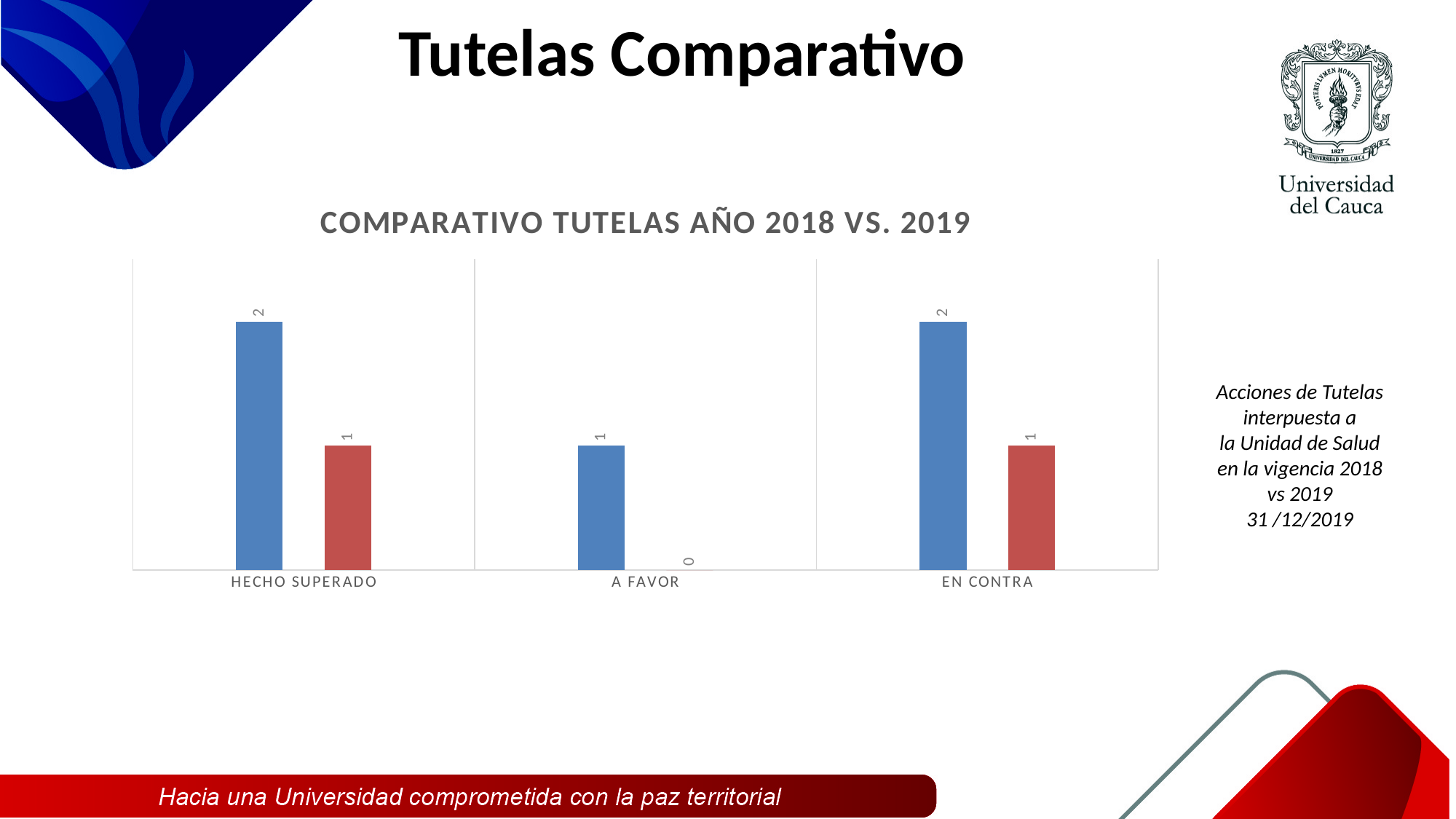
Which category has the lowest value for the red bars? A FAVOR What is the value of the red bar for EN CONTRA? 1 Which category has the lowest value for the blue bars? A FAVOR How many categories are shown on the x axis of the chart? 3 What is the title of the chart? COMPARATIVO TUTELAS AÑO 2018 VS. 2019 What is the value of the red bar for HECHO SUPERADO? 1 Which is larger for HECHO SUPERADO, the blue bar or the red bar? The blue bar What is the value of the red bar for A FAVOR? 0 What is the difference between the blue bar and the red bar for EN CONTRA? 1 What is the value of the blue bar for A FAVOR? 1 What type of chart is shown on the slide? Bar chart What is the value of the blue bar for HECHO SUPERADO? 2